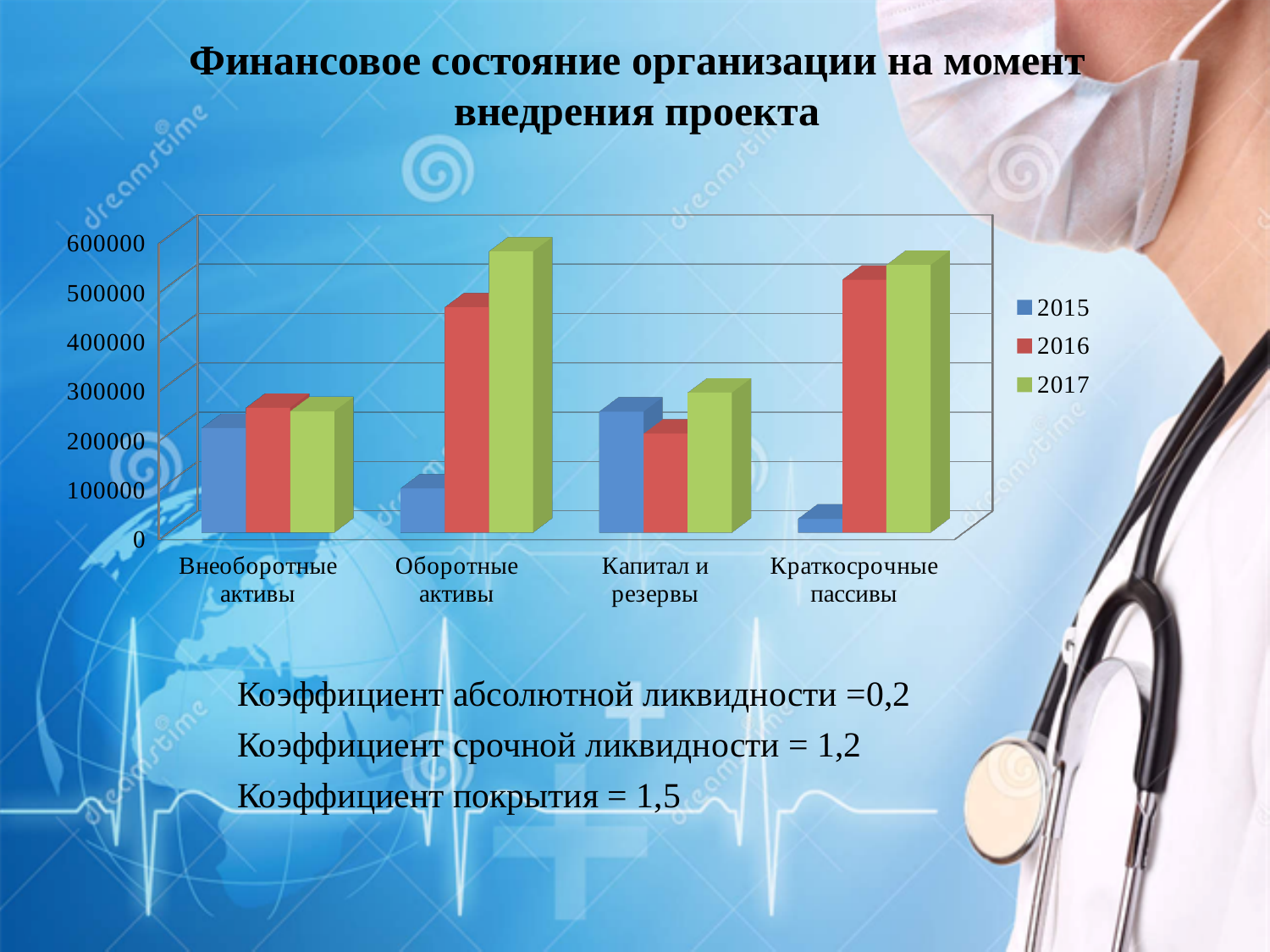
Is the 2016 value for Краткосрочные пассивы greater or less than 400000? greater Is the 2015 value for Краткосрочные пассивы greater or less than 100000? less How many series does the chart legend list? 3 Do the values for Оборотные активы rise or fall from 2015 to 2017? rise How many categories are shown on the x axis of the chart? 4 Which category has the lowest value for 2015? Краткосрочные пассивы For 2016, which is larger: Оборотные активы or Внеоборотные активы? Оборотные активы What kind of chart is shown on the slide? bar chart Is the 2017 value for Оборотные активы greater or less than 500000? greater Which years are listed in the chart legend? 2015, 2016, 2017